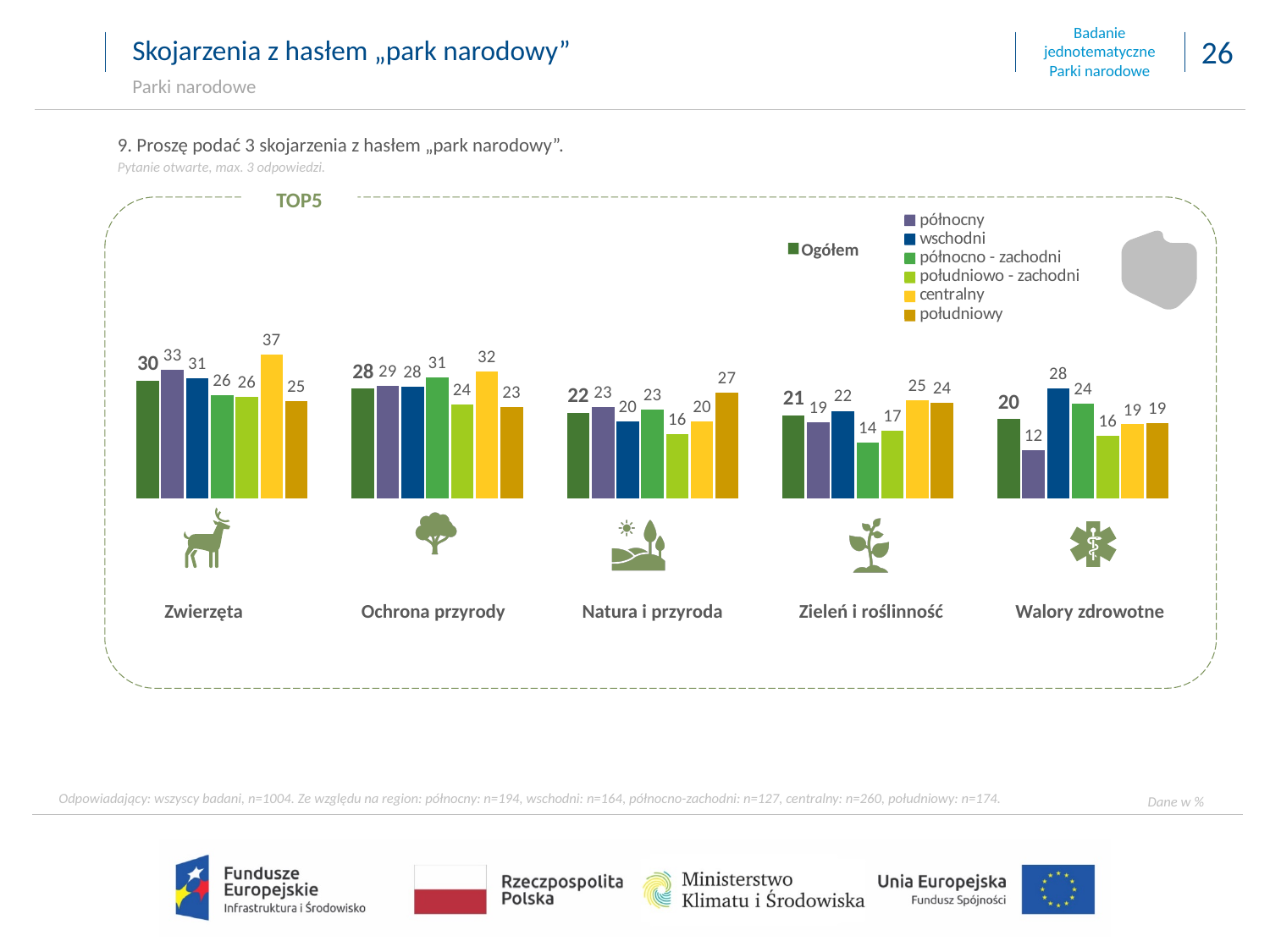
Which category has the highest Ogółem value? Zwierzęta What is the value for the południowy region for Natura i przyroda? 27 How many categories are shown in the chart? 5 Which is larger for Zieleń i roślinność: the centralny value or the południowo - zachodni value? centralny Do the Ogółem values rise or fall from Zwierzęta to Walory zdrowotne? fall What kind of chart is shown on the slide? bar chart What is the difference between the centralny and południowy values for Zwierzęta? 12 Which category has the lowest Ogółem value? Walory zdrowotne What is the value for the centralny region for Zwierzęta? 37 What is the value for the północny region for Walory zdrowotne? 12 What is the Ogółem value for Zwierzęta? 30 How many series does the legend list? 7